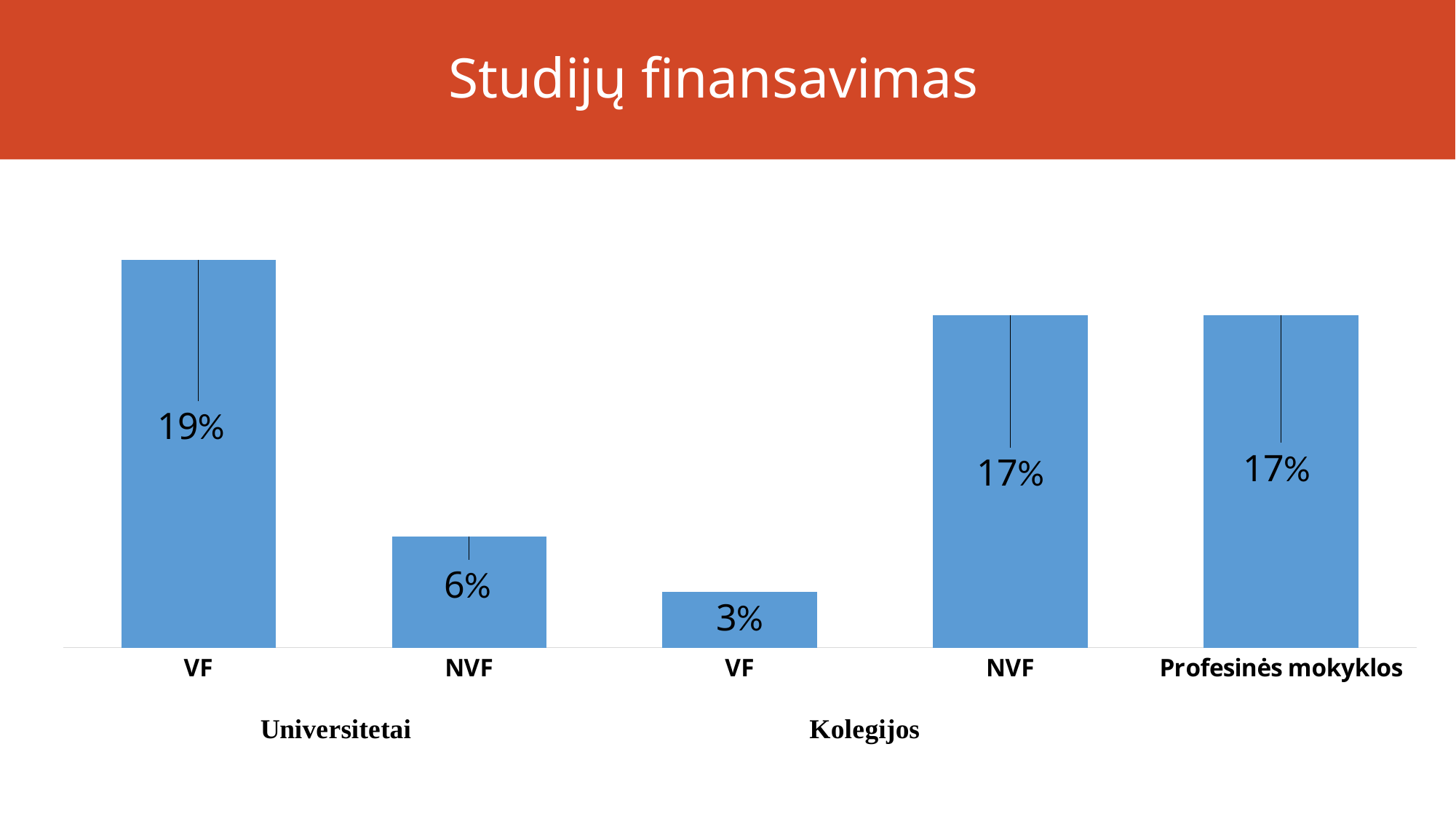
Which bar has the lowest value? VF (Kolegijos) What is the difference between NVF under Kolegijos and VF under Kolegijos? 14% What is the value for VF under Kolegijos? 3% How many bars are shown in the chart? 5 What is the difference between VF under Universitetai and NVF under Universitetai? 13% What is the value for VF under Universitetai? 19% Which is larger, NVF under Universitetai or VF under Kolegijos? NVF under Universitetai What is the value for Profesinės mokyklos? 17% What type of chart is shown on the slide? Bar chart What is the value for NVF under Universitetai? 6% Which bar has the highest value? VF (Universitetai) What is the value for NVF under Kolegijos? 17%